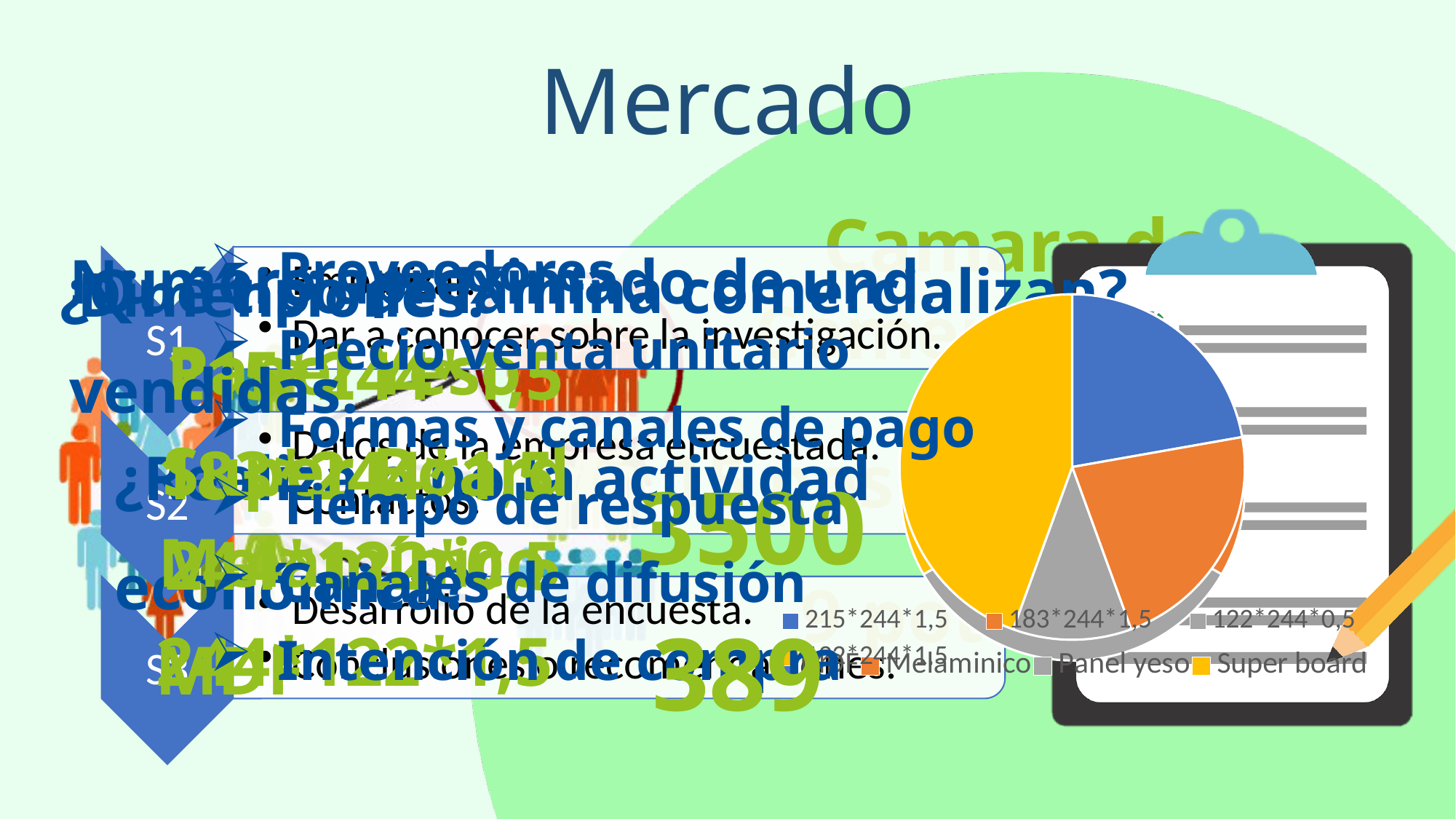
Which colour slice is the smallest in the pie chart? gray Is the blue slice or the gray slice larger in the pie chart? blue How many slices does the pie chart have? 4 In the legend listing material names, which colour is assigned to Super board? yellow Which colour slice is the largest in the pie chart? yellow What kind of chart is shown on the slide? pie chart In the legend listing material names, which colour is assigned to Panel yeso? gray Is the yellow slice or the orange slice larger in the pie chart? yellow